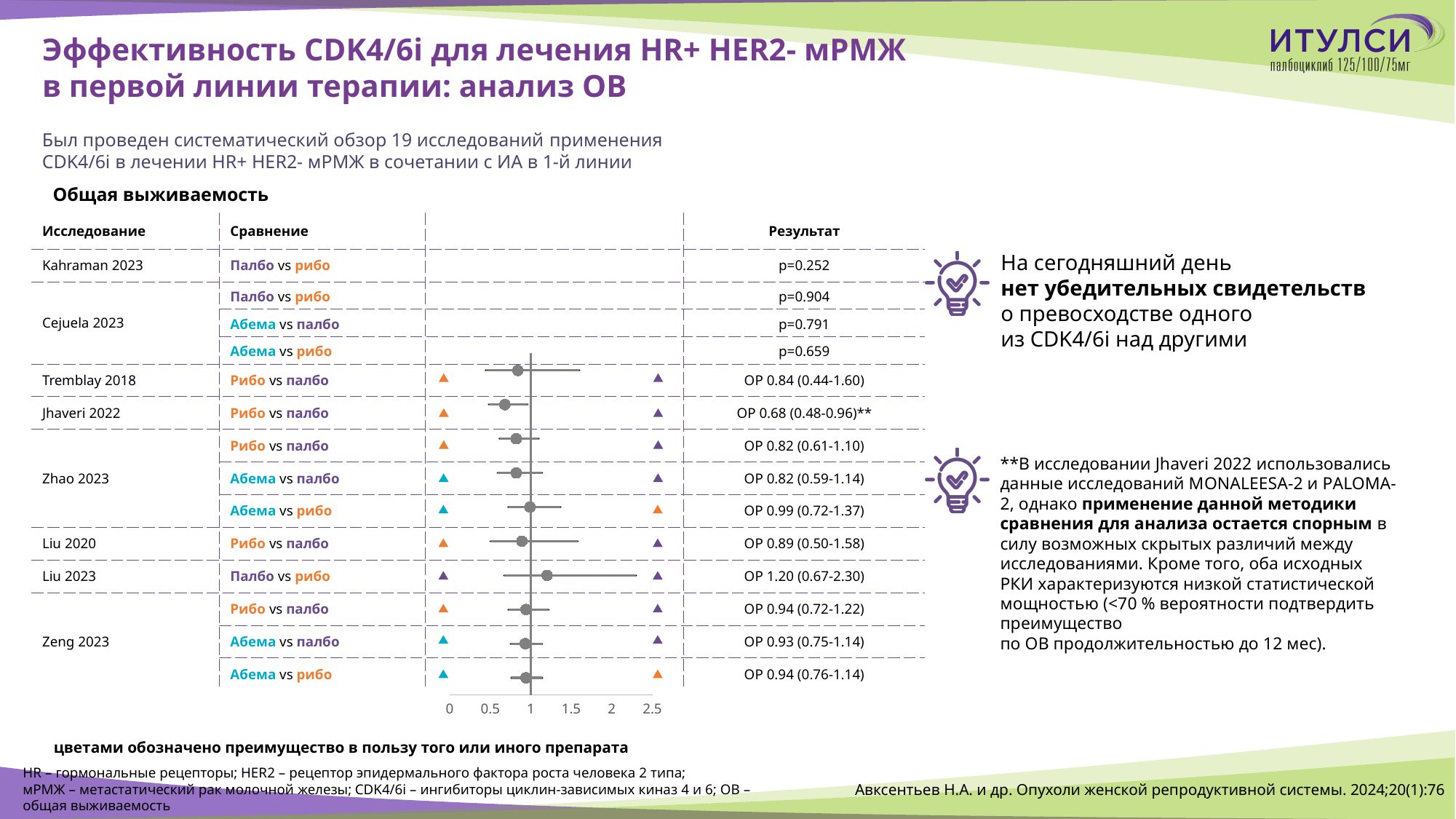
What is the highest tick value shown on the x axis of the forest plot? 2.5 What is the ОР value for Liu 2023 (Палбо vs рибо)? 1.20 What is the difference between the ОР for Liu 2023 (Палбо vs рибо) and the ОР for Jhaveri 2022 (Рибо vs палбо)? 0.52 Which has the larger ОР: Zhao 2023 (Абема vs рибо) or Liu 2020 (Рибо vs палбо)? Zhao 2023 (Абема vs рибо) What is the result (ОР) shown for Tremblay 2018 (Рибо vs палбо)? ОР 0.84 (0.44-1.60) What is the ОР value for Jhaveri 2022 (Рибо vs палбо)? 0.68 Which study row has the highest ОР point estimate in the forest plot? Liu 2023 (Палбо vs рибо) What p-value is shown for Kahraman 2023 (Палбо vs рибо)? p=0.252 Is the ОР point estimate for Liu 2023 (Палбо vs рибо) greater or less than 1? greater Which study row has the lowest ОР point estimate in the forest plot? Jhaveri 2022 (Рибо vs палбо) What kind of chart is used to display the ОР results? Forest plot How many study rows have a point estimate with confidence interval plotted in the forest plot? 10